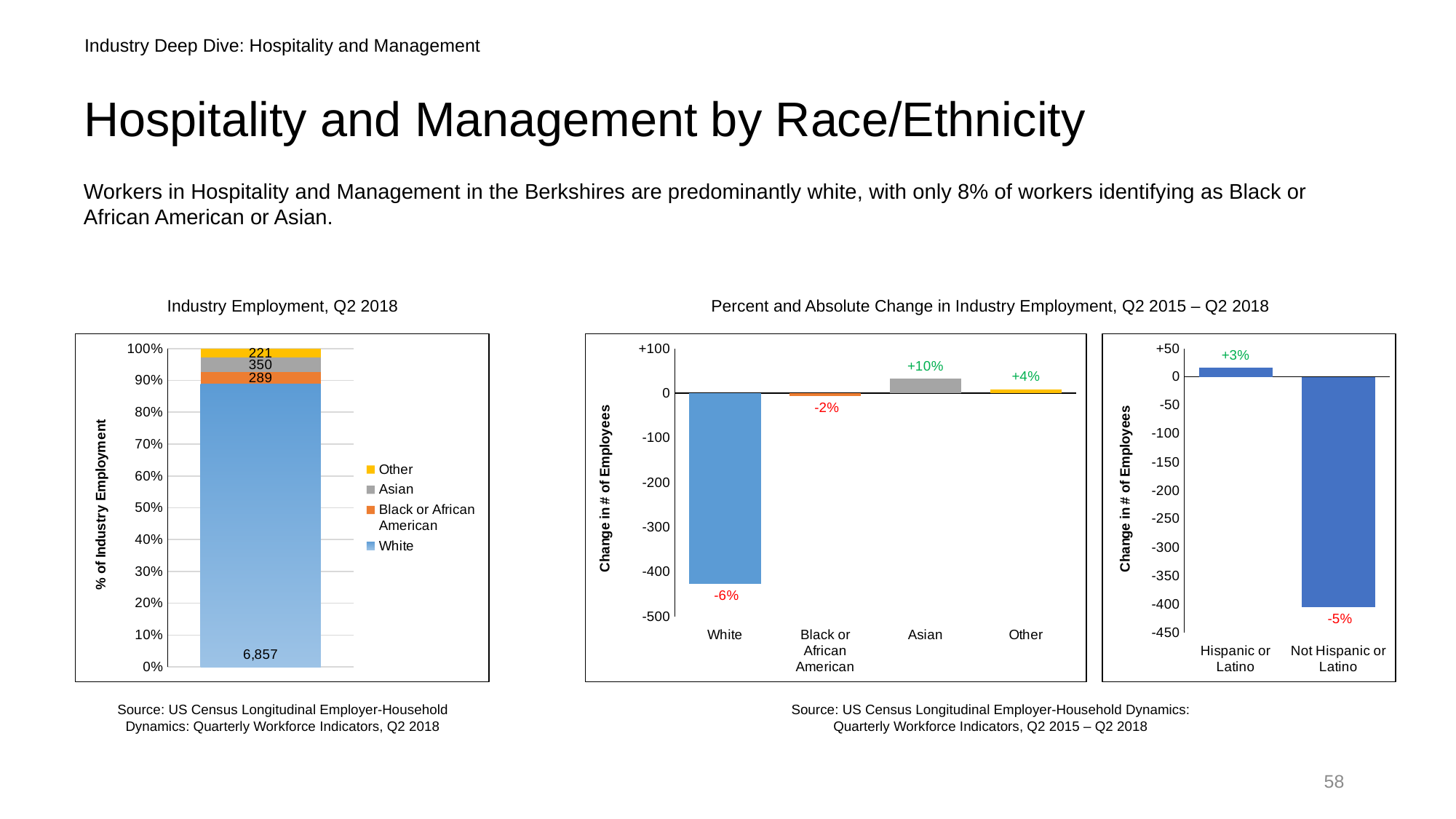
In the Industry Employment, Q2 2018 chart, how many employees are shown for White? 6,857 In the Percent and Absolute Change chart by race (middle chart), how many race/ethnicity categories are shown on the x axis? 4 In the Industry Employment, Q2 2018 chart, what is the difference between the Asian and Black or African American values? 61 What kind of chart is the Industry Employment, Q2 2018 chart? Stacked bar chart In the Percent and Absolute Change chart by race (middle chart), what percent change is labeled for White? -6% In the Industry Employment, Q2 2018 chart, which group has the smallest number of employees? Other How many series does the legend of the Industry Employment, Q2 2018 chart list? 4 In the Percent and Absolute Change chart by race (middle chart), is the change in number of employees for White greater or less than -400? less In the Percent and Absolute Change chart by Hispanic origin (right chart), what percent change is labeled for Not Hispanic or Latino? -5% In the Industry Employment, Q2 2018 chart, what value is shown for Asian? 350 In the Percent and Absolute Change chart by race (middle chart), what percent change is labeled for Asian? +10% In the Industry Employment, Q2 2018 chart, what is the total of all four segments of the stacked bar? 7,717